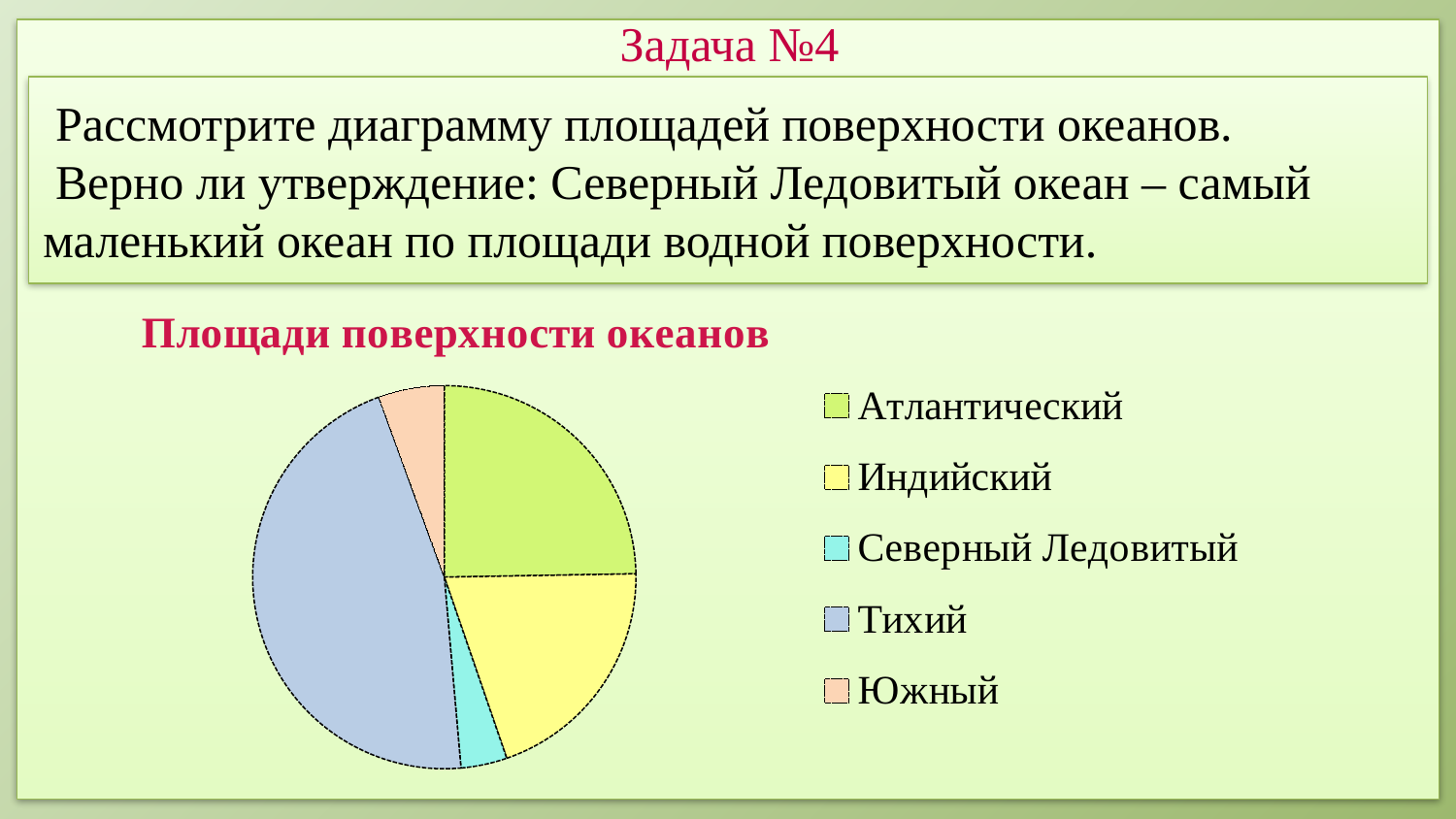
Which slice is larger: Тихий or Атлантический? Тихий Which slice is larger: Тихий or Индийский? Тихий How many categories (oceans) does the pie chart show? 5 Which ocean has the smallest slice in the pie chart? Северный Ледовитый What kind of chart is shown on the slide? pie chart Which ocean has the largest slice in the pie chart? Тихий Which slice is larger: Индийский or Северный Ледовитый? Индийский What is the title of the chart? Площади поверхности океанов